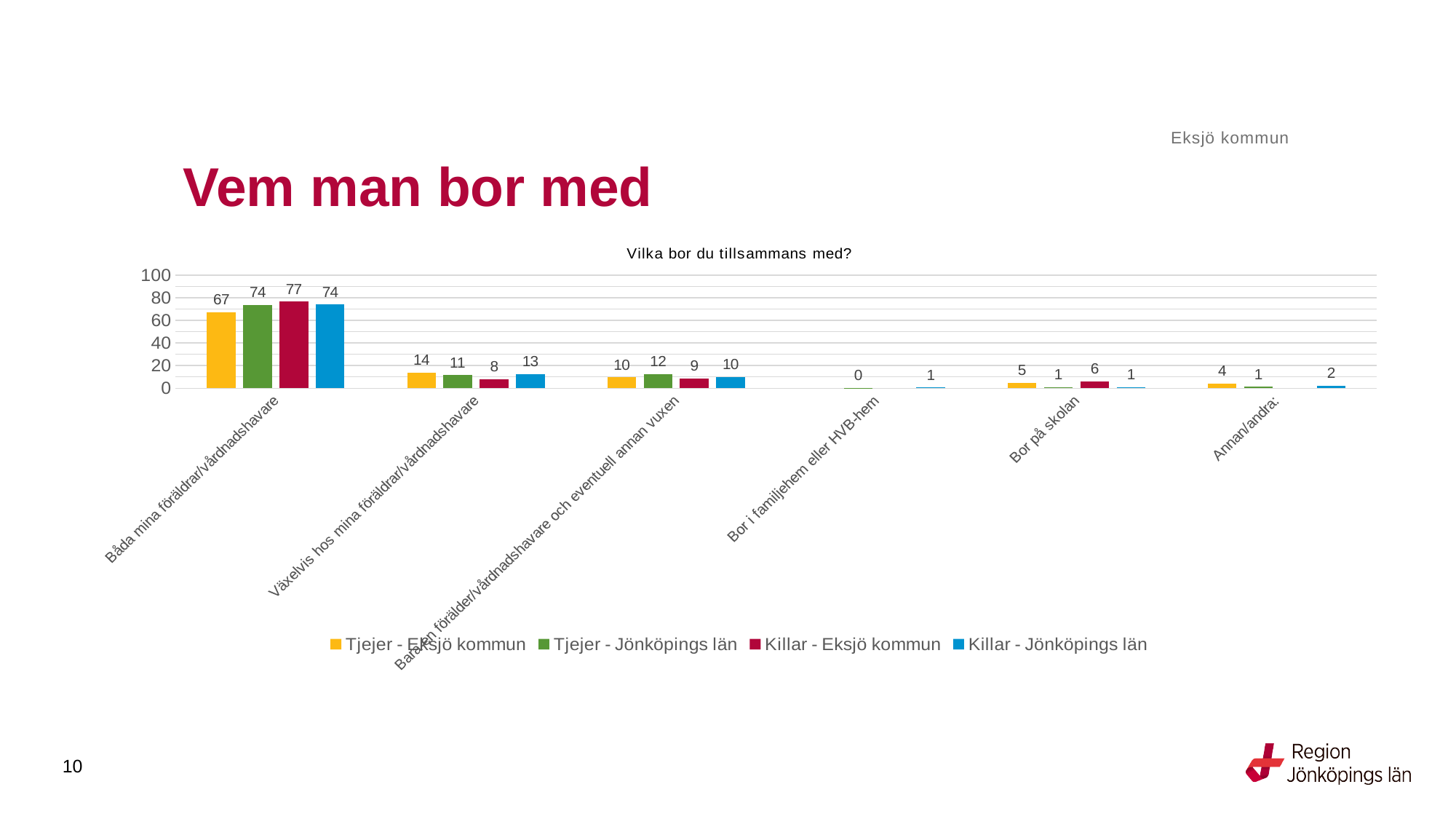
Is the value for Tjejer - Eksjö kommun in 'Båda mina föräldrar/vårdnadshavare' greater or less than 60? greater What is the title of the chart? Vilka bor du tillsammans med? What type of chart is shown on the slide? bar chart Which series has the lowest value in the category 'Växelvis hos mina föräldrar/vårdnadshavare'? Killar - Eksjö kommun What is the value for Tjejer - Jönköpings län in the category 'Bara en förälder/vårdnadshavare och eventuell annan vuxen'? 12 How many categories are shown on the x axis? 6 What is the value for Tjejer - Eksjö kommun in the category 'Växelvis hos mina föräldrar/vårdnadshavare'? 14 In the category 'Bor på skolan', which is larger: Tjejer - Eksjö kommun or Killar - Eksjö kommun? Killar - Eksjö kommun How many series does the legend list? 4 Which series has the highest value in the category 'Båda mina föräldrar/vårdnadshavare'? Killar - Eksjö kommun What is the value for Killar - Eksjö kommun in the category 'Båda mina föräldrar/vårdnadshavare'? 77 What is the difference between Killar - Eksjö kommun and Tjejer - Eksjö kommun in the category 'Båda mina föräldrar/vårdnadshavare'? 10